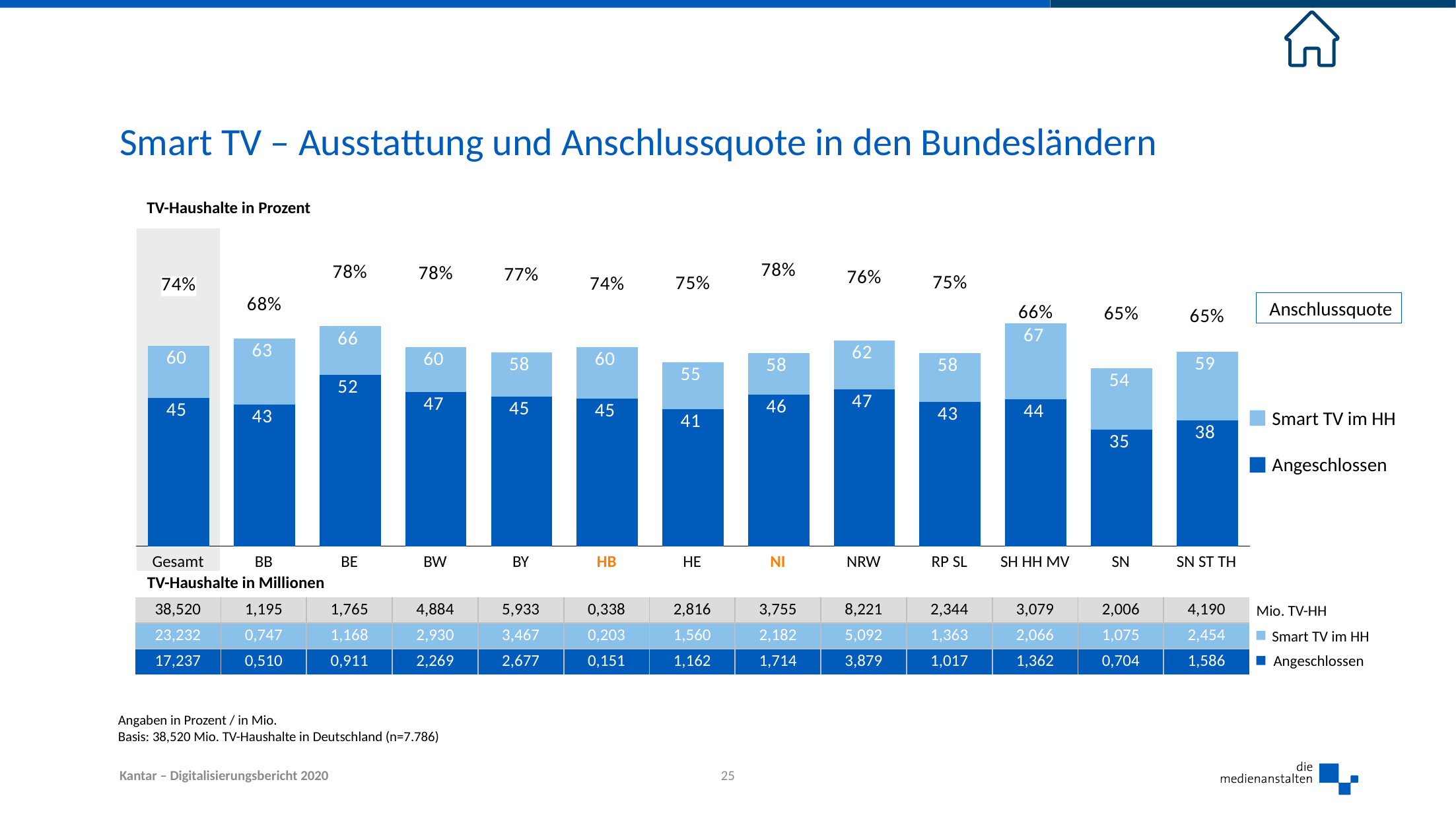
Which category has the highest Angeschlossen value? BE What kind of chart is shown on the slide? bar chart How many series does the chart legend list? 2 Which category has the highest Smart TV im HH value? SH HH MV Which category has the lowest Angeschlossen value? SN How many categories are shown along the x axis of the chart? 13 What is the Angeschlossen value for Gesamt? 45 What Anschlussquote is shown above the bar for NRW? 76% What is the title of the slide? Smart TV – Ausstattung und Anschlussquote in den Bundesländern What is the difference between the Smart TV im HH value and the Angeschlossen value for BE? 14 Which has the larger Angeschlossen value, BW or SN? BW What is the Smart TV im HH value for HE? 55